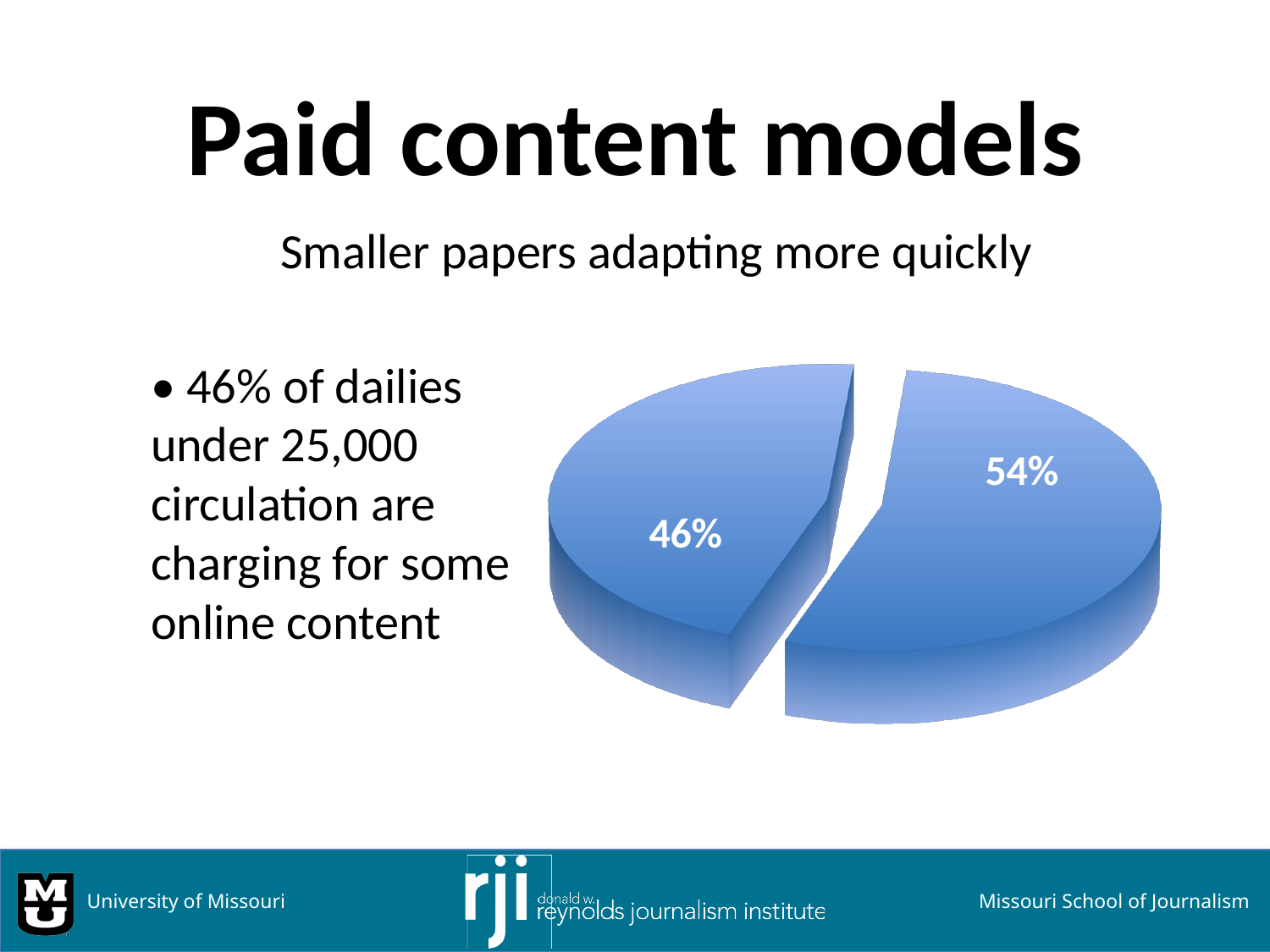
What percentage is shown on the left slice of the pie chart? 46% What is the smallest value shown on the pie chart? 46% How many slices does the pie chart have? 2 What kind of chart is shown on the slide? pie chart What is the largest value shown on the pie chart? 54% What is the title of the slide containing the pie chart? Paid content models Is the value of the right slice of the pie chart greater or less than 50%? greater What percentage is shown on the right slice of the pie chart? 54% What is the difference between the two slices of the pie chart? 8% Is the value of the left slice of the pie chart greater or less than 50%? less Which slice of the pie chart is larger, the left one or the right one? the right one (54%) What colour are the slices of the pie chart? blue